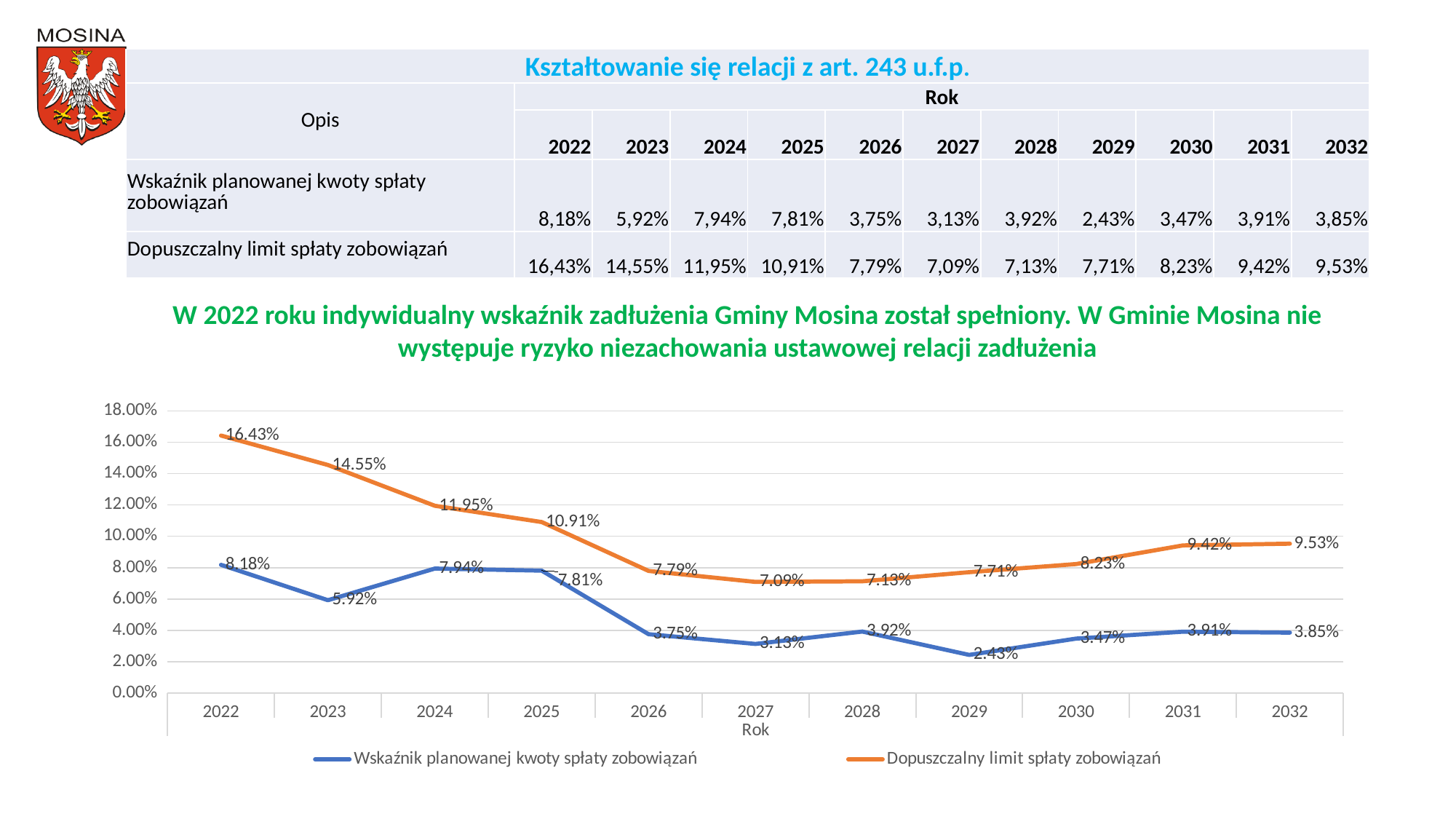
In which year is 'Dopuszczalny limit spłaty zobowiązań' at its lowest? 2027 How many series does the chart legend list? 2 Does 'Dopuszczalny limit spłaty zobowiązań' rise or fall between 2022 and 2027? fall What colour is the line for 'Wskaźnik planowanej kwoty spłaty zobowiązań'? blue How many years are plotted along the x axis of the chart? 11 What kind of chart is shown on the slide? line chart What is the value of 'Dopuszczalny limit spłaty zobowiązań' in 2032? 9.53% Which series has the higher value in 2026? Dopuszczalny limit spłaty zobowiązań What is the difference between 'Dopuszczalny limit spłaty zobowiązań' and 'Wskaźnik planowanej kwoty spłaty zobowiązań' in 2022? 8.25% In which year is 'Wskaźnik planowanej kwoty spłaty zobowiązań' at its highest? 2022 What is the value of 'Wskaźnik planowanej kwoty spłaty zobowiązań' in 2029? 2.43% What is the value of 'Dopuszczalny limit spłaty zobowiązań' in 2022? 16.43%